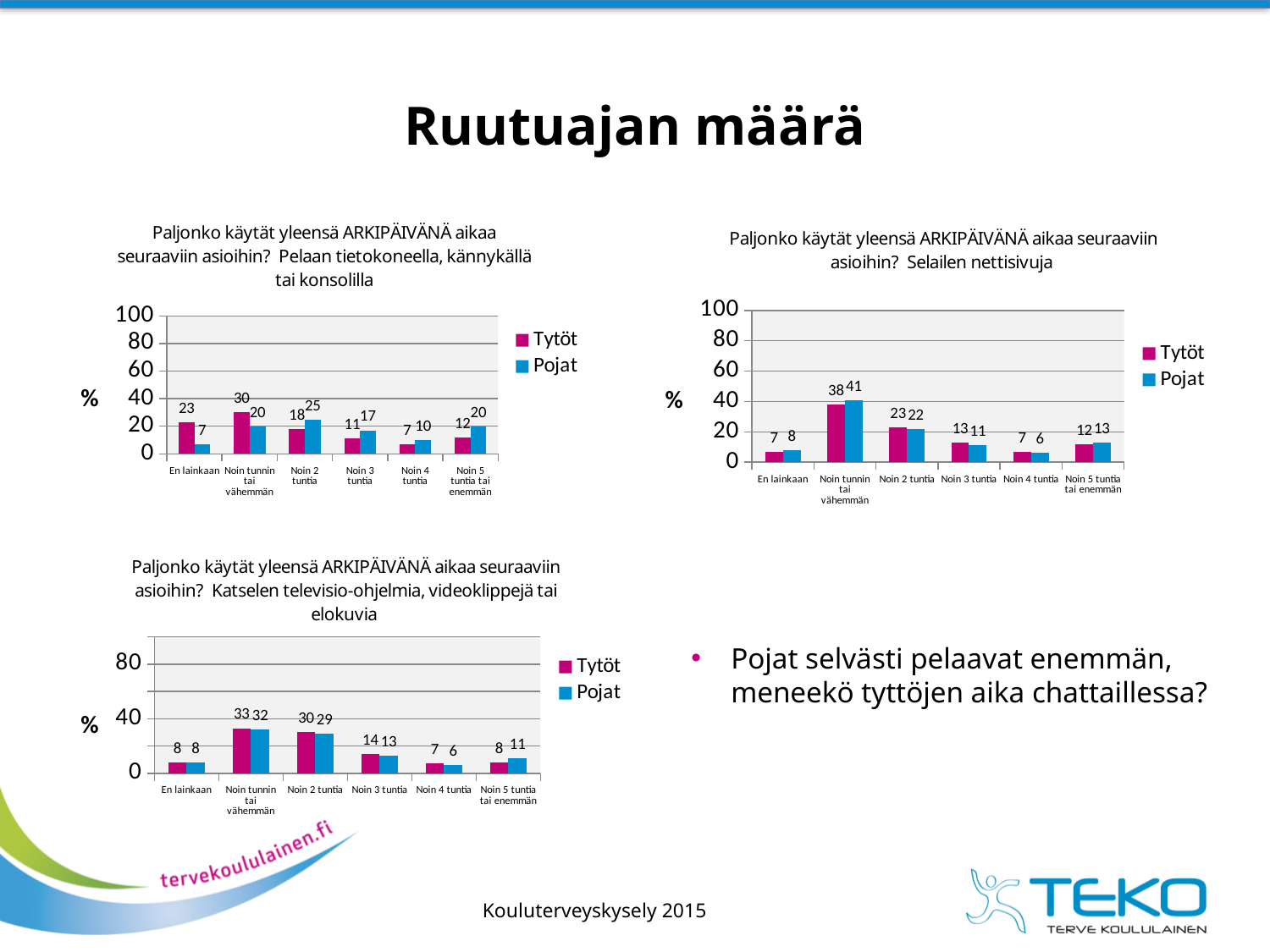
In the top-right chart (Selailen nettisivuja), is the value for Tytöt in 'Noin tunnin tai vähemmän' greater or less than 20? greater In the bottom-left chart (Katselen televisio-ohjelmia, videoklippejä tai elokuvia), what is the value for Tytöt in the 'Noin 2 tuntia' category? 30 In the top-left chart (Pelaan tietokoneella, kännykällä tai konsolilla), what is the value for Tytöt in the 'En lainkaan' category? 23 In the top-right chart (Selailen nettisivuja), what is the value for Pojat in the 'Noin tunnin tai vähemmän' category? 41 How many categories are shown on the x axis of the bottom-left chart (Katselen televisio-ohjelmia, videoklippejä tai elokuvia)? 6 In the top-right chart (Selailen nettisivuja), which category has the lowest value for Pojat? Noin 4 tuntia In the top-left chart (Pelaan tietokoneella, kännykällä tai konsolilla), what is the value for Pojat in the 'Noin 2 tuntia' category? 25 In the top-left chart (Pelaan tietokoneella, kännykällä tai konsolilla), which category has the highest value for Tytöt? Noin tunnin tai vähemmän What type of chart is the top-left chart (Pelaan tietokoneella, kännykällä tai konsolilla)? Bar chart In the top-left chart (Pelaan tietokoneella, kännykällä tai konsolilla), what is the difference between Tytöt and Pojat in the 'En lainkaan' category? 16 How many series does the legend of the top-right chart (Selailen nettisivuja) list? 2 In the bottom-left chart (Katselen televisio-ohjelmia, videoklippejä tai elokuvia), which is larger in the 'Noin 5 tuntia tai enemmän' category, Tytöt or Pojat? Pojat